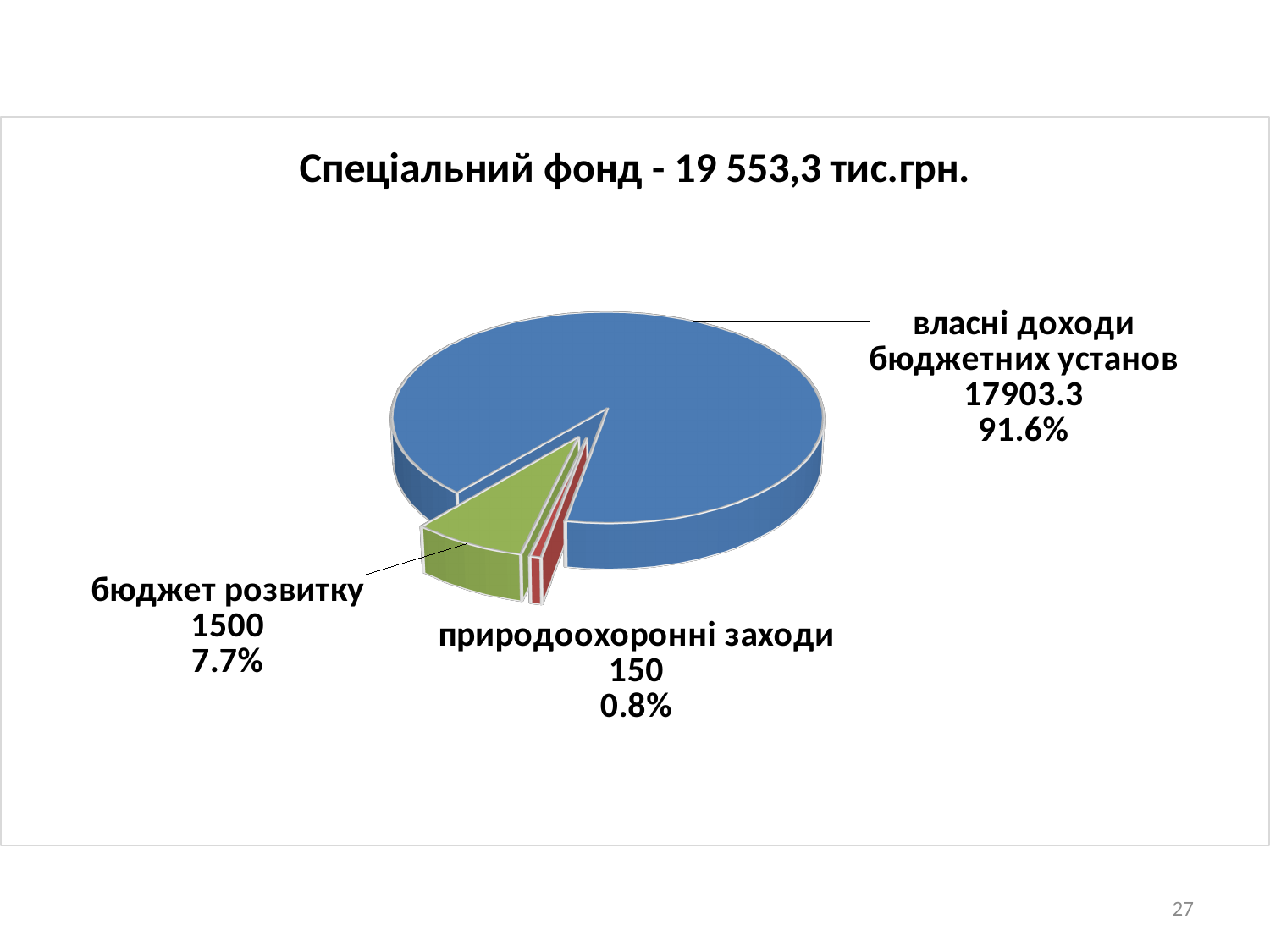
What is the value for природоохоронні заходи? 150 Which category has the smallest slice? природоохоронні заходи Which category has the largest slice? власні доходи бюджетних установ How many slices does the pie chart have? 3 What is the value for власні доходи бюджетних установ? 17903.3 What kind of chart is shown on the slide? pie chart What share of the pie does природоохоронні заходи represent? 0.8% What share of the pie does бюджет розвитку represent? 7.7% What is the title of the chart? Спеціальний фонд - 19 553,3 тис.грн. What share of the pie does власні доходи бюджетних установ represent? 91.6% What is the value for бюджет розвитку? 1500 What is the difference between the values for бюджет розвитку and природоохоронні заходи? 1350